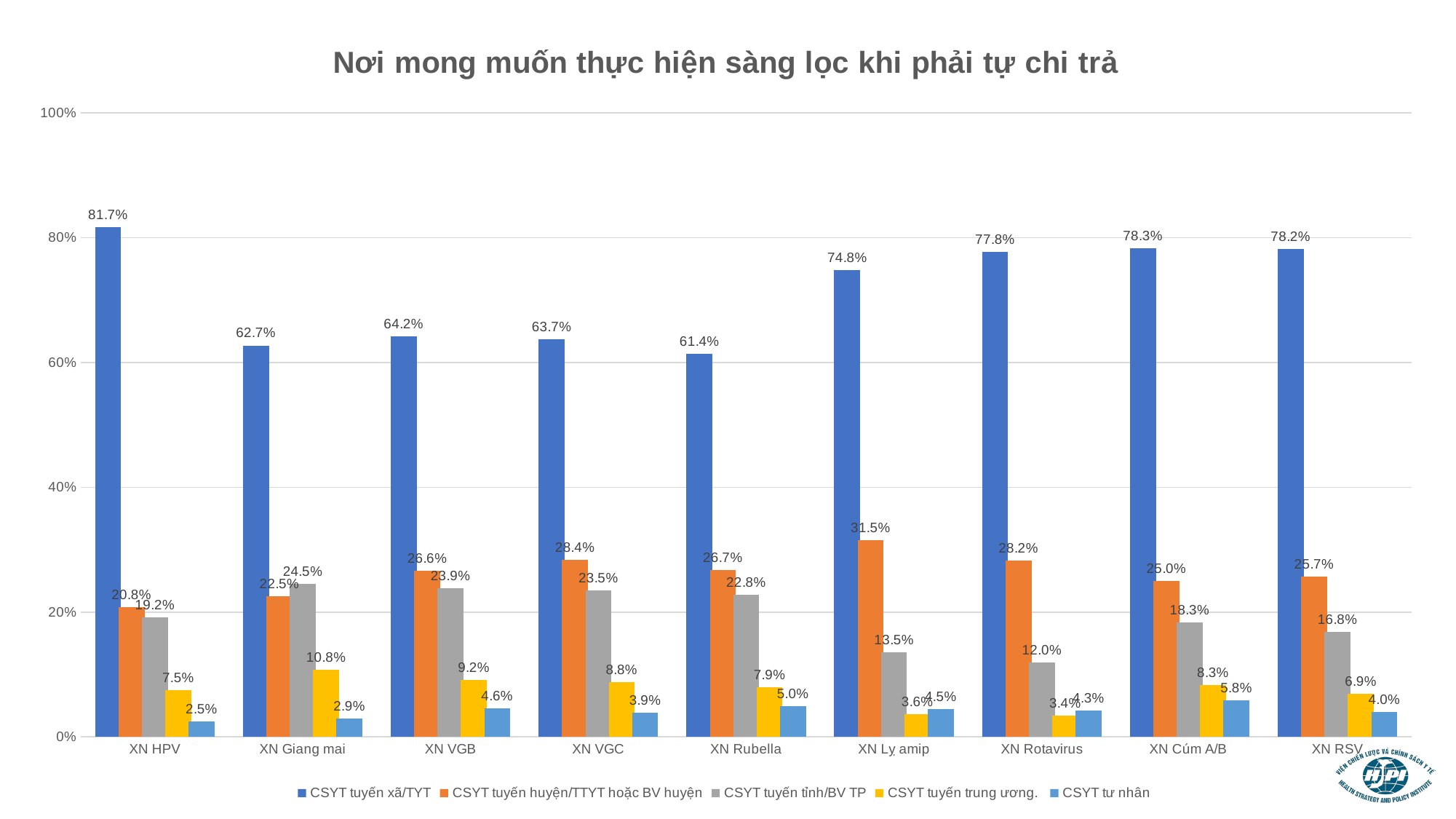
Which is larger for XN Giang mai: CSYT tuyến huyện/TTYT hoặc BV huyện or CSYT tuyến tỉnh/BV TP? CSYT tuyến tỉnh/BV TP Which category has the highest value for CSYT tuyến xã/TYT? XN HPV What is the value for CSYT tư nhân for XN Cúm A/B? 5.8% What is the difference between the CSYT tuyến xã/TYT values for XN HPV and XN Rubella? 20.3% What is the value for CSYT tuyến xã/TYT for XN HPV? 81.7% What is the value for CSYT tuyến huyện/TTYT hoặc BV huyện for XN Lỵ amip? 31.5% Is the value for CSYT tuyến xã/TYT for XN Lỵ amip greater or less than 60%? greater What is the value for CSYT tuyến trung ương for XN Giang mai? 10.8% Which category has the lowest value for CSYT tuyến xã/TYT? XN Rubella What kind of chart is shown on the slide? Bar chart How many series does the legend list? 5 How many categories are shown on the x axis? 9